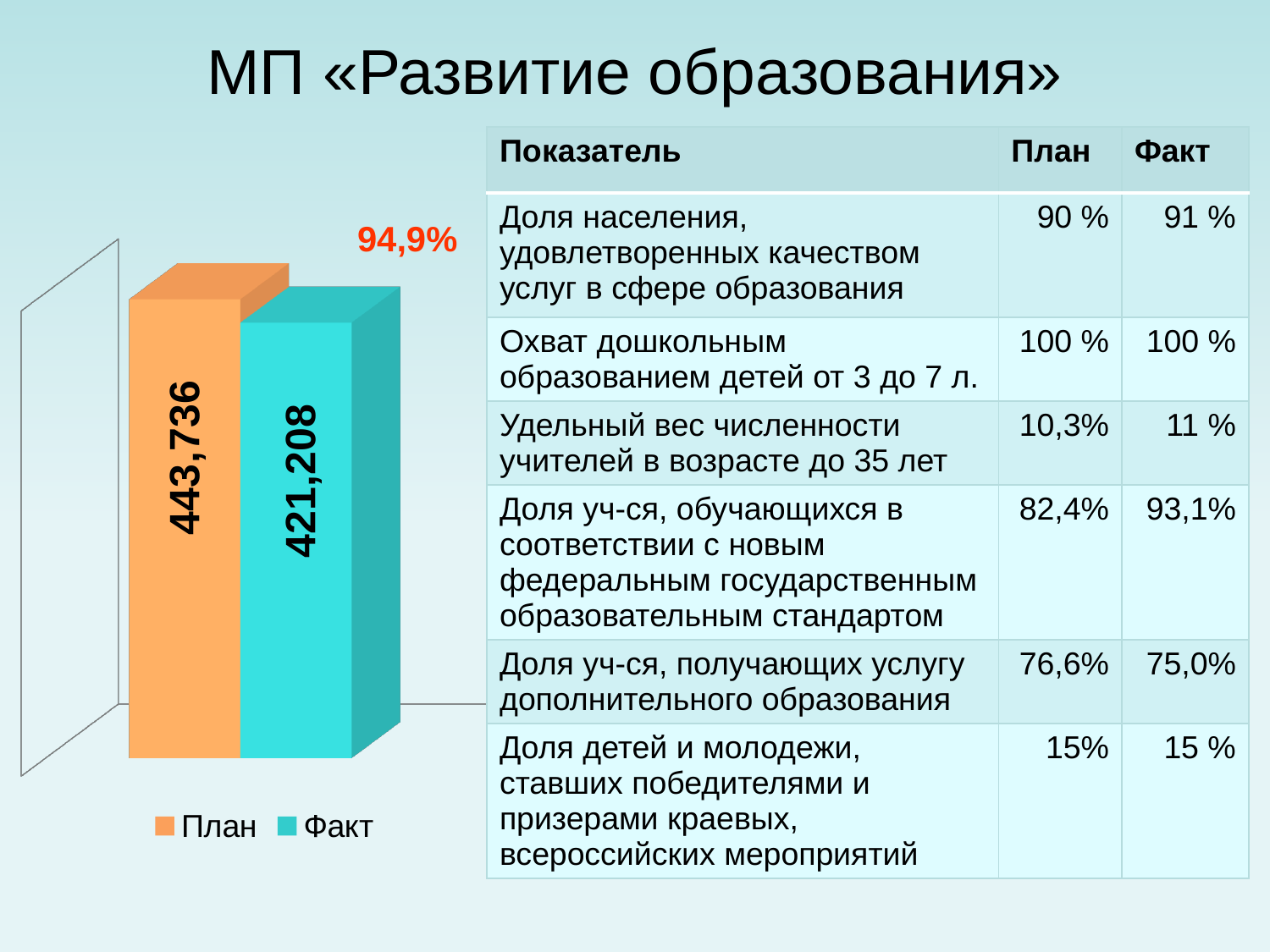
What kind of chart is shown on the left of the slide? Bar chart What colour is the Факт bar in the chart? Turquoise Which series has the highest value in the chart? План What is the value of the Факт bar in the chart? 421,208 What is the difference between the План and Факт values in the chart? 22,528 What percentage is printed above the bars in the chart? 94,9% Which series has the lowest value in the chart? Факт What is the value of the План bar in the chart? 443,736 How many series does the chart legend list? 2 Which bar in the chart is higher, План or Факт? План How many bars are plotted in the chart? 2